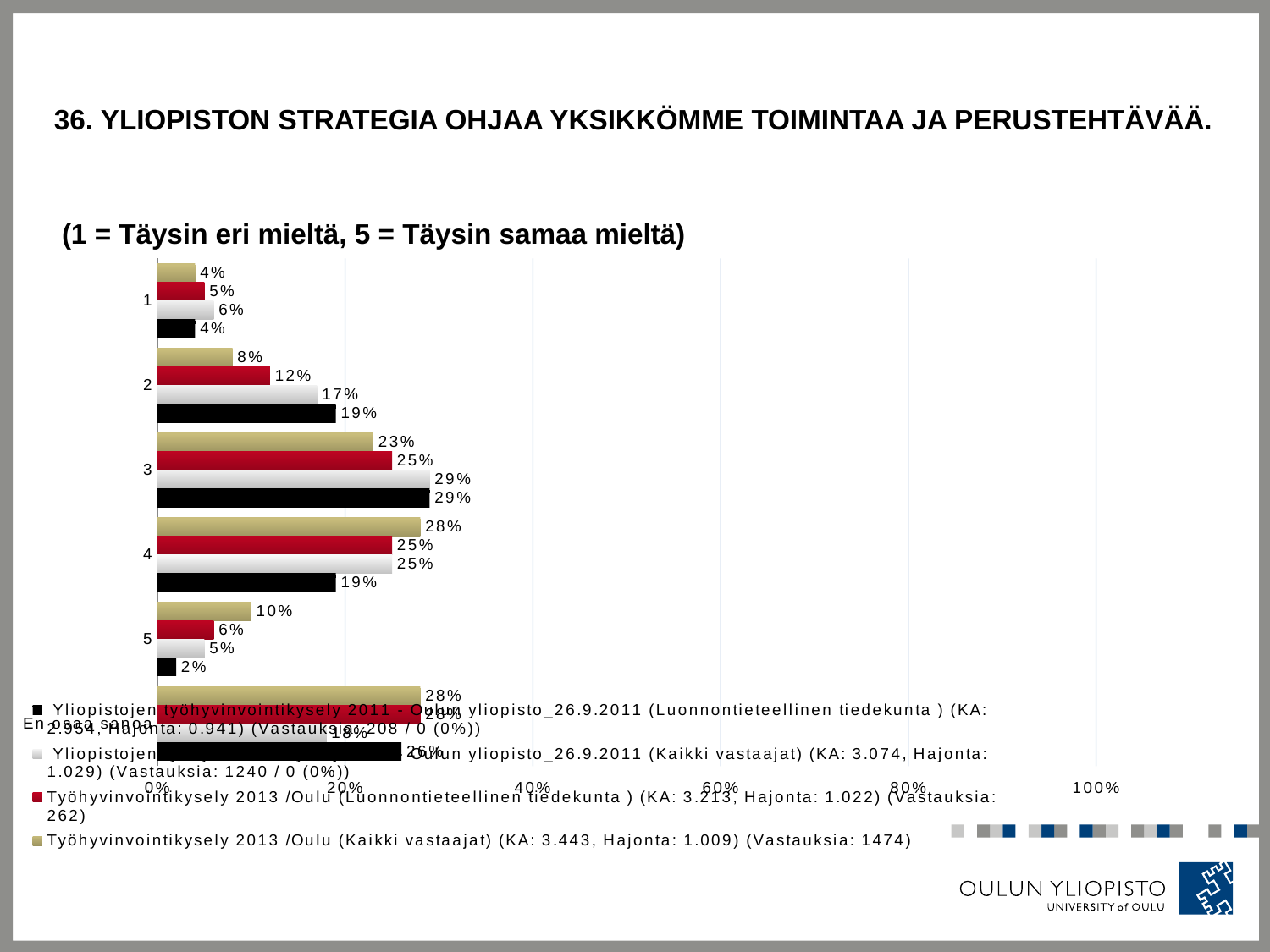
What is the difference between the red bar and the tan bar for category 5? 4% What kind of chart is shown on the slide? bar chart What is the value of the red bar (Työhyvinvointikysely 2013 /Oulu, Luonnontieteellinen tiedekunta) for category 3? 25% For the black series (2011, Luonnontieteellinen tiedekunta), which category from 1 to 5 has the lowest value? 5 What is the value of the light gray bar (2011, Kaikki vastaajat) for category 5? 5% How many series does the legend list? 4 What is the value of the tan bar (Työhyvinvointikysely 2013 /Oulu, Kaikki vastaajat) for category 4? 28% What is the difference between the black bar and the tan bar for category 2? 11% For category 5, which is larger: the tan bar (2013, Kaikki vastaajat) or the black bar (2011, Luonnontieteellinen tiedekunta)? the tan bar (2013, Kaikki vastaajat) Is the value of the light gray bar for category 3 greater or less than 20%? greater For the tan series (2013, Kaikki vastaajat), which category from 1 to 5 has the highest value? 4 What is the value of the black bar (2011, Luonnontieteellinen tiedekunta) for category 2? 19%